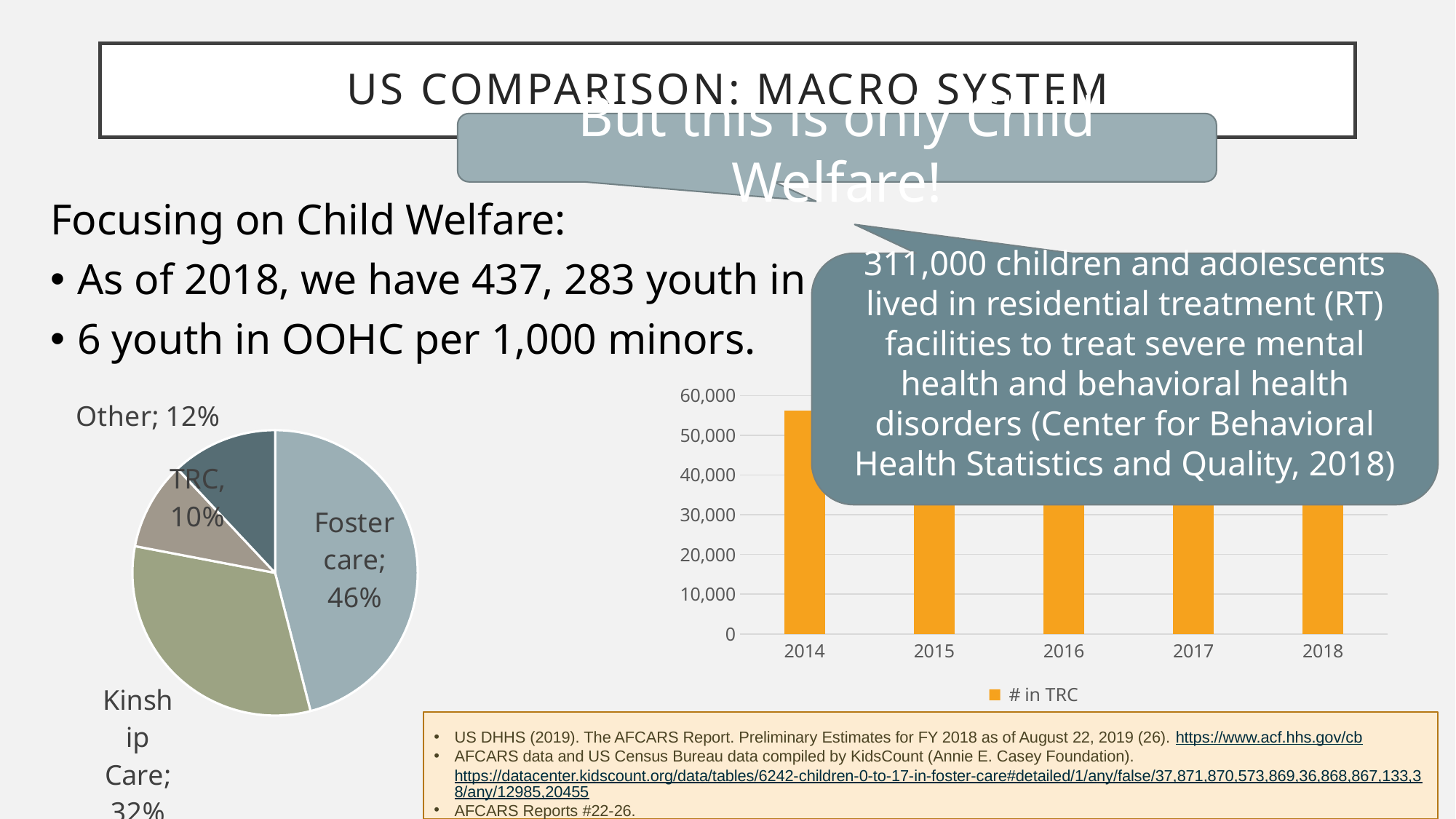
In the pie chart on the left, which is larger: Other or TRC? Other How many slices does the pie chart on the left have? 4 In the pie chart on the left, how many percentage points larger is Foster care than Kinship Care? 14% In the pie chart on the left, which category has the smallest share? TRC What type of chart is the chart on the right showing # in TRC? Bar chart In the pie chart on the left, what share is labelled for Foster care? 46% In the bar chart on the right, is the value for 2014 greater or less than 50,000? greater In the pie chart on the left, what share is labelled for Kinship Care? 32% In the bar chart on the right, what series name does the legend show? # in TRC In the bar chart on the right, how many years are shown on the x axis? 5 In the pie chart on the left, which category has the largest share? Foster care In the pie chart on the left, what share is labelled for TRC? 10%